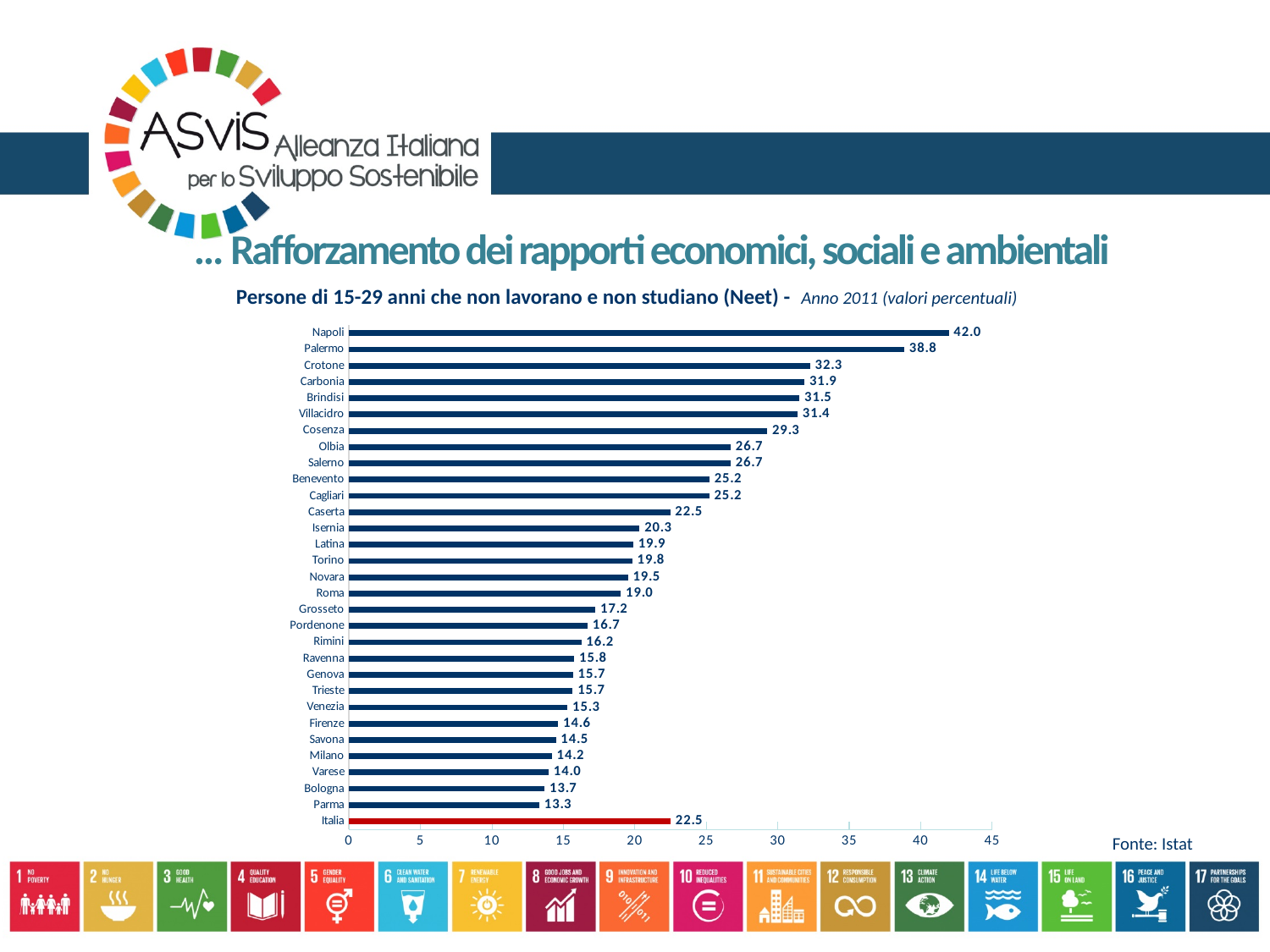
What kind of chart is shown on the slide? bar chart Which category has the highest value? Napoli What is the value for Napoli? 42.0 Is the value for Crotone greater or less than 30? greater What is the difference between the values for Napoli and Palermo? 3.2 How many categories are shown on the chart? 31 Which is larger, the value for Cosenza or the value for Olbia? Cosenza What is the difference between the values for Roma and Italia? 3.5 Which bar is shown in a different colour (red) from the others? Italia Which category has the lowest value? Parma What is the value for Milano? 14.2 What is the value for Italia? 22.5